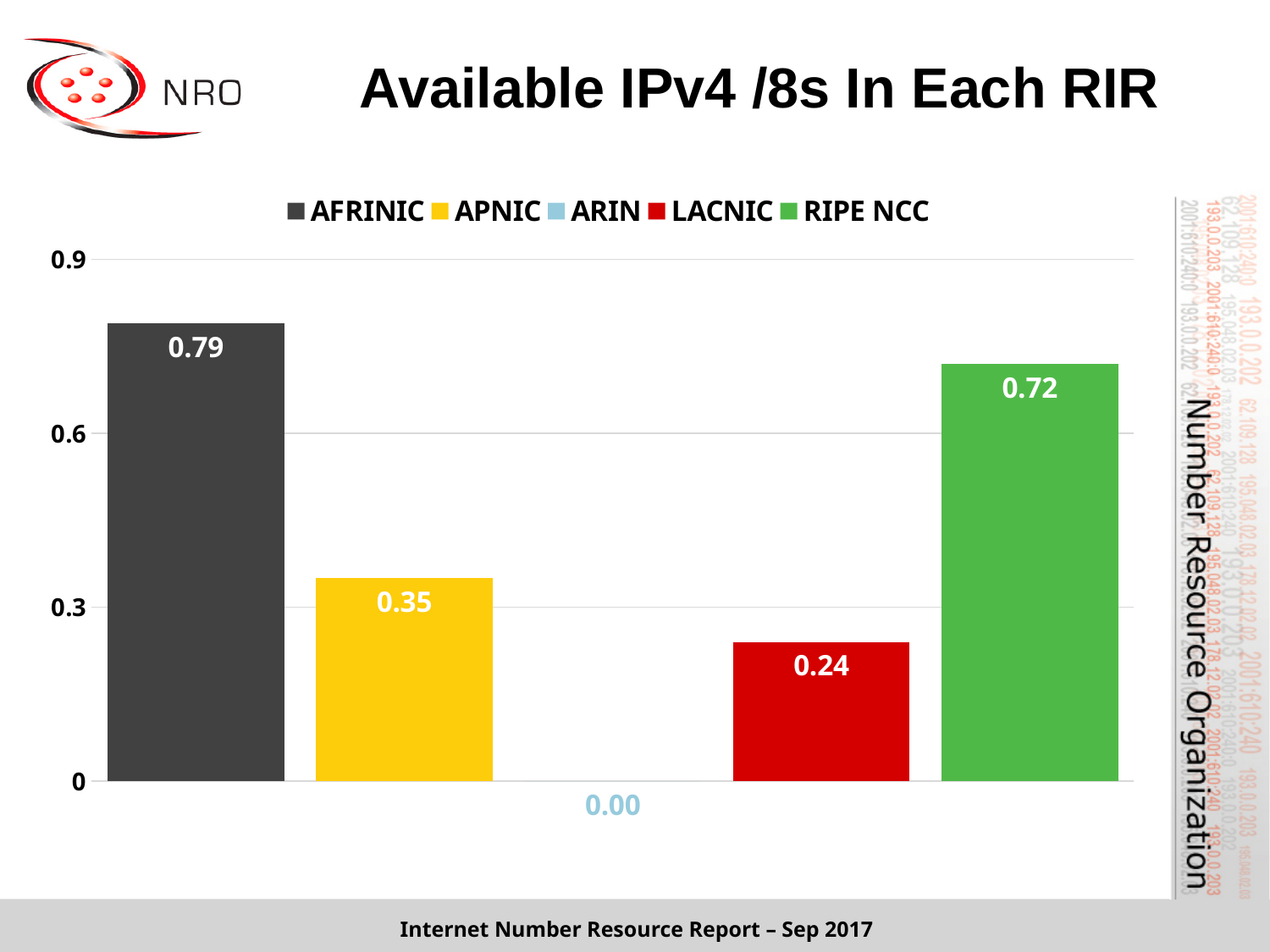
What is the value for APNIC? 0.35 What is the difference between the values for AFRINIC and RIPE NCC? 0.07 What is the value for LACNIC? 0.24 Which RIR has the highest number of available IPv4 /8s? AFRINIC How many RIRs are shown in the chart? 5 What is the value for RIPE NCC? 0.72 What is the value for AFRINIC? 0.79 What kind of chart is shown on the slide? Bar chart What is the title of the chart? Available IPv4 /8s In Each RIR Which is larger, the value for APNIC or the value for LACNIC? APNIC What is the value for ARIN? 0.00 Which RIR has the lowest number of available IPv4 /8s? ARIN